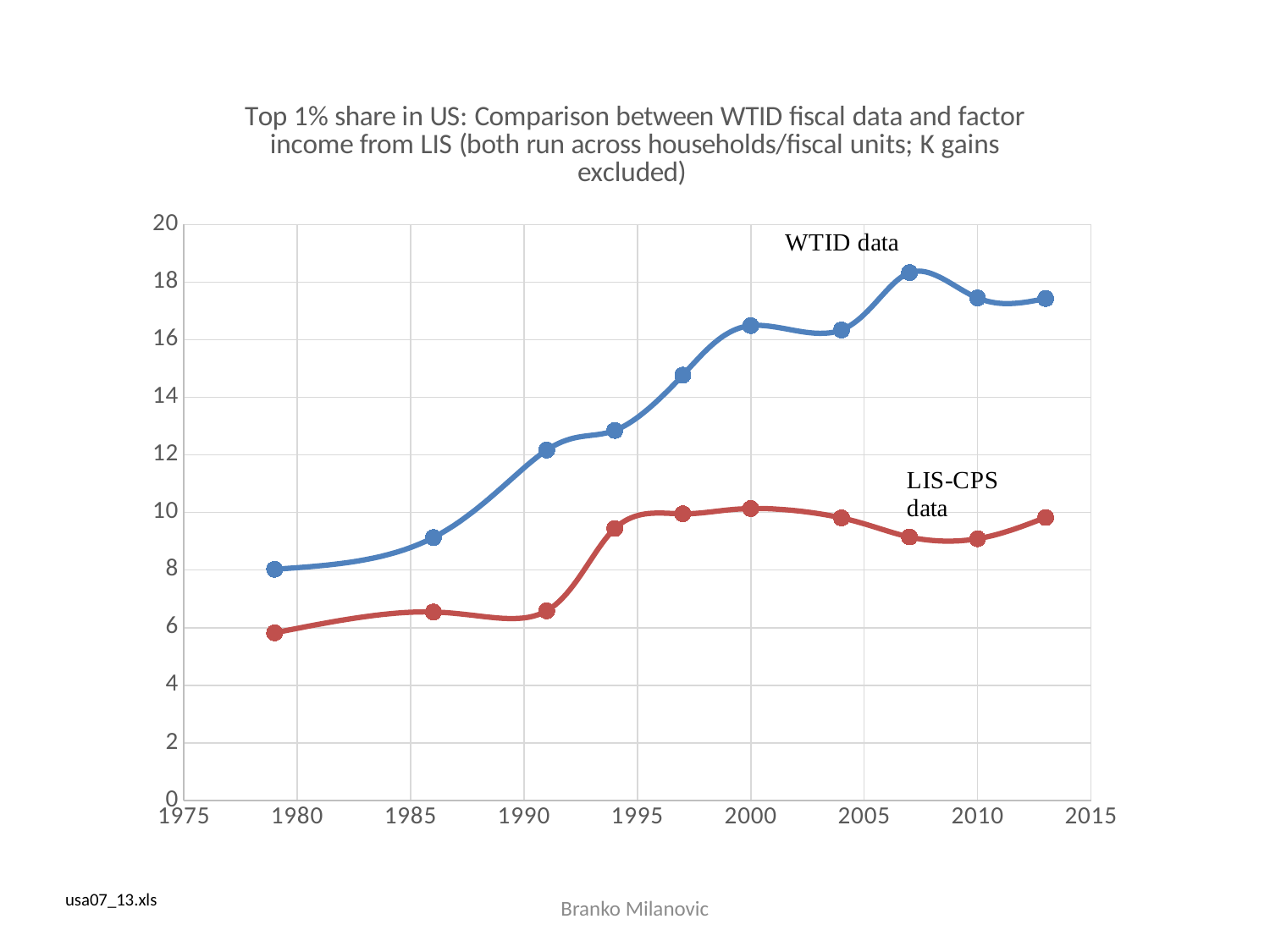
Is the value for WTID data at the year 2010 greater or less than 18? less Is the value for LIS-CPS data at the year 1986 greater or less than 8? less Is the value for WTID data at the year 2000 greater or less than 16? greater What colour is the line for the WTID data series? Blue How many data points does the WTID data series have? 10 Does the WTID data series generally rise or fall from 1979 to 2013? Rise Which series is higher at the year 2000, WTID data or LIS-CPS data? WTID data What kind of chart is shown on the slide? Line chart What is the name of the source file shown at the bottom left of the slide? usa07_13.xls How many data series are plotted on the chart? 2